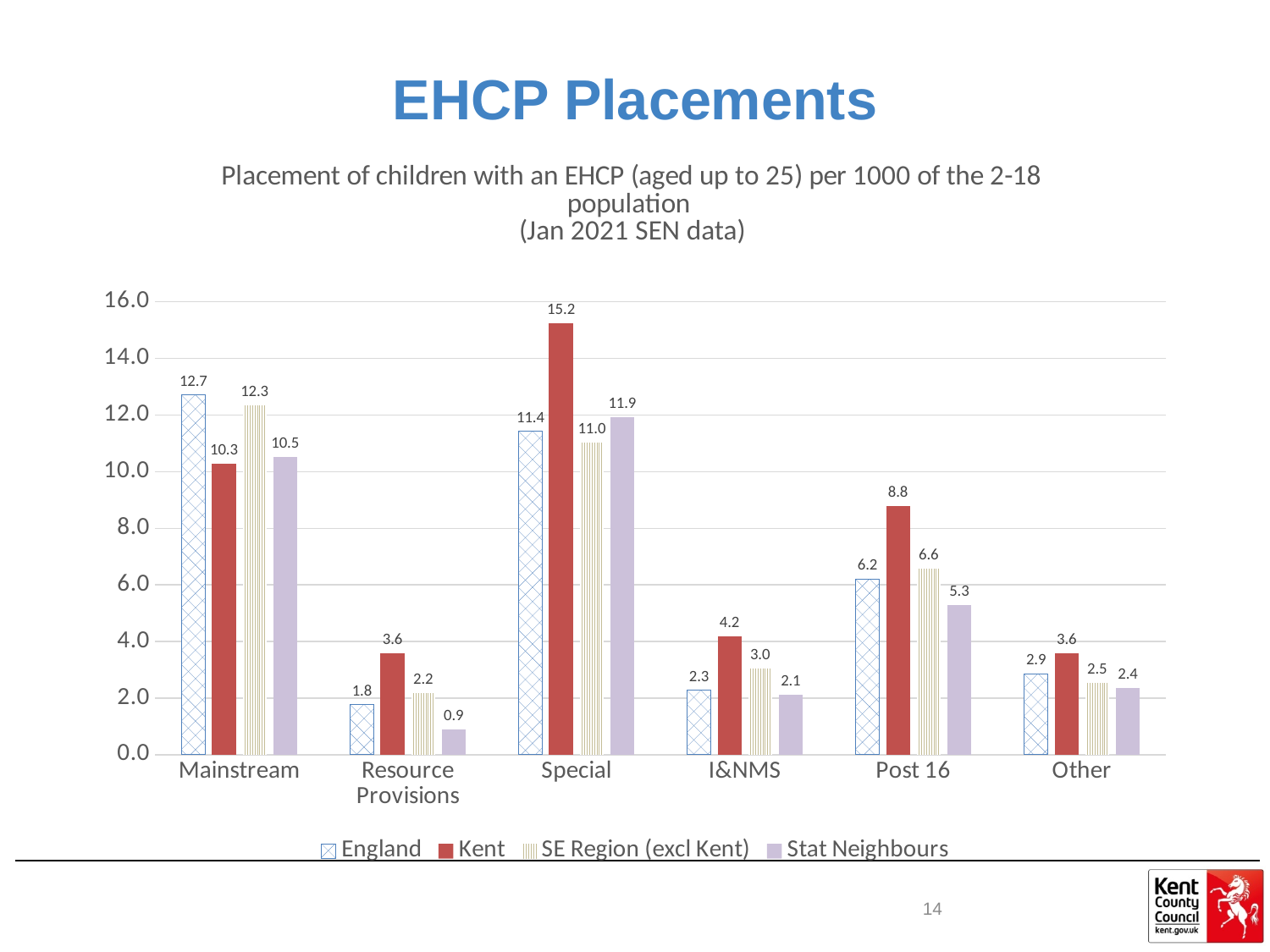
What is the value for Kent in the Special category? 15.2 Which is larger in the Mainstream category, the value for England or the value for Kent? England How many categories are shown on the x axis? 6 What is the difference between the Kent and England values in the Special category? 3.8 What is the total of the four series values in the I&NMS category? 11.6 Which category has the highest value for Kent? Special What is the value for Stat Neighbours in the Resource Provisions category? 0.9 Which category has the lowest value for England? Resource Provisions What kind of chart is shown on the slide? Bar chart What is the value for SE Region (excl Kent) in the Post 16 category? 6.6 How many series does the legend list? 4 What is the value for England in the Mainstream category? 12.7